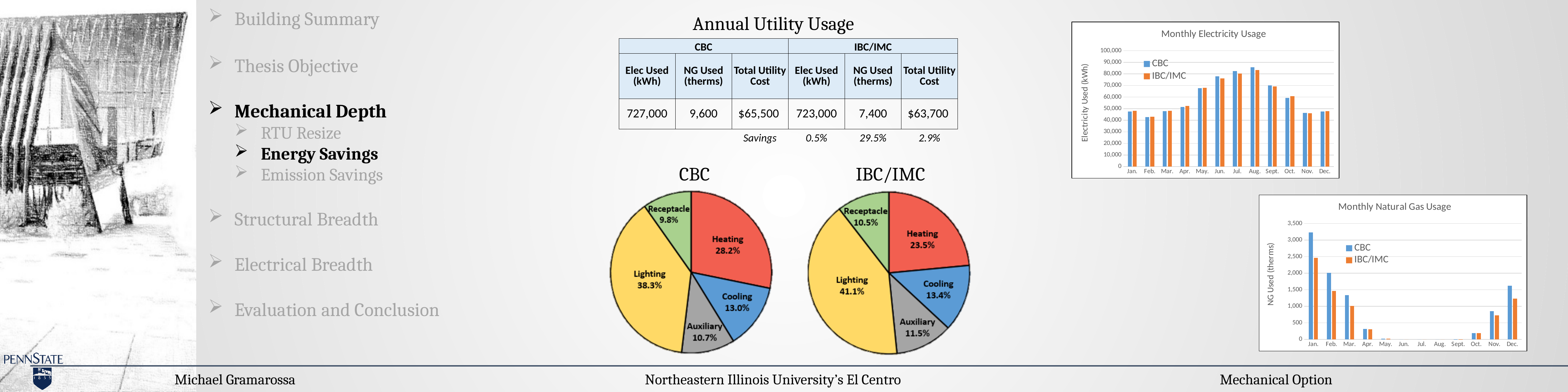
In the IBC/IMC pie chart, what share of energy use is Heating? 23.5% In the CBC pie chart, what share of energy use is Lighting? 38.3% In the Monthly Electricity Usage chart, which month has the highest CBC value? Aug. How many series does the legend of the Monthly Electricity Usage chart list? 2 In the Monthly Electricity Usage chart, is the CBC value for Aug. greater or less than 80,000? greater What is the difference between the Heating share in the CBC pie chart and the Heating share in the IBC/IMC pie chart? 4.7% What kind of chart is the Monthly Natural Gas Usage chart? Bar chart In the Monthly Natural Gas Usage chart, is the CBC value for Jan. greater or less than 3,000? greater In the IBC/IMC pie chart, which category has the largest share? Lighting In the CBC pie chart, which category has the smallest share? Receptacle In the IBC/IMC pie chart, which is larger, the Cooling share or the Auxiliary share? Cooling How many slices does the CBC pie chart have? 5